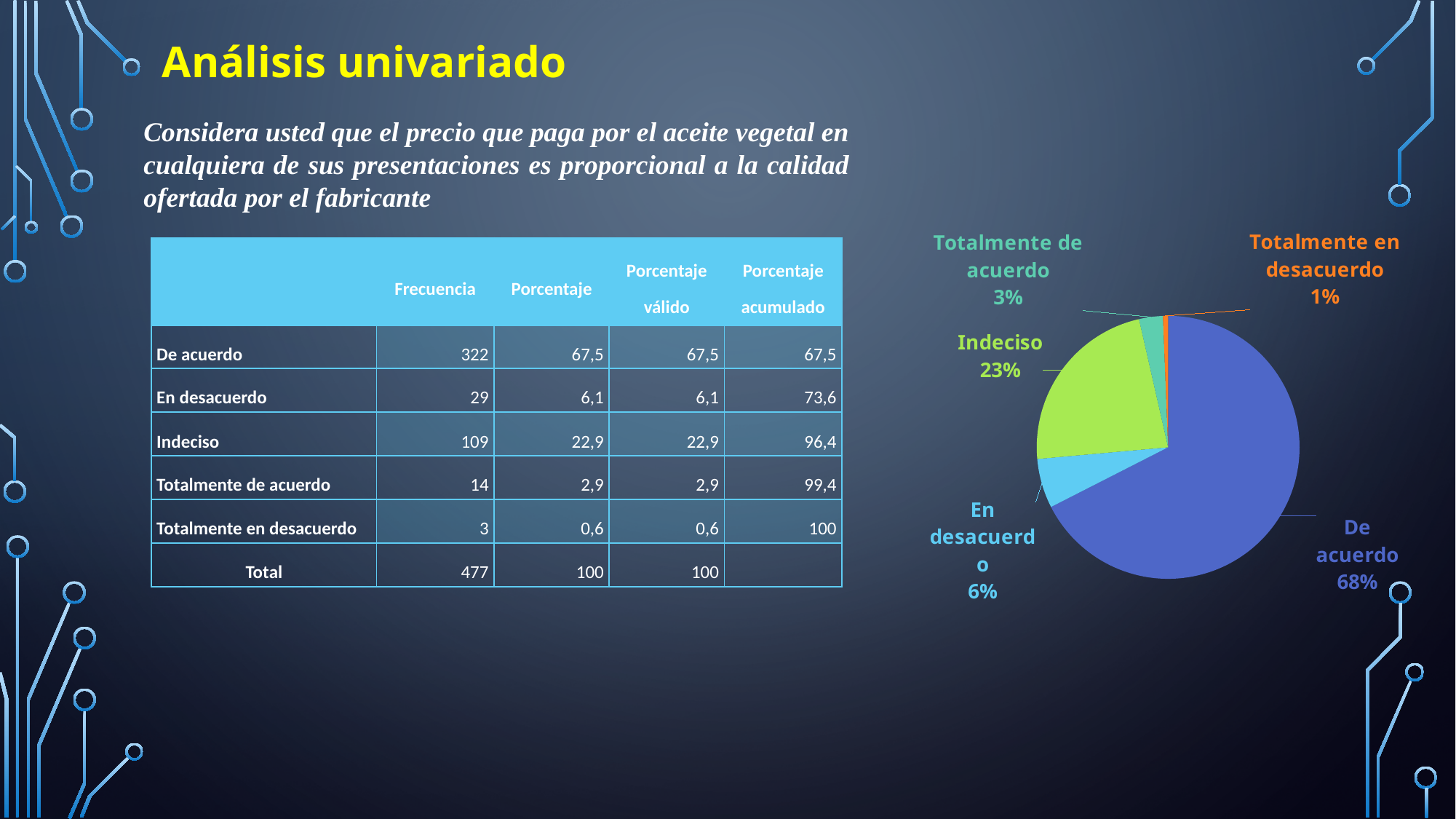
Which slice of the pie chart is the largest? De acuerdo What kind of chart is shown on the slide? pie chart What colour is the De acuerdo slice in the pie chart? blue How many slices does the pie chart have? 5 In the pie chart, what share is labelled for Totalmente de acuerdo? 3% In the pie chart, what share is labelled for Indeciso? 23% In the pie chart, what is the difference in percentage points between De acuerdo and Indeciso? 45 Which slice of the pie chart is the smallest? Totalmente en desacuerdo In the pie chart, what share is labelled for De acuerdo? 68% In the pie chart, what share is labelled for En desacuerdo? 6% In the pie chart, what share is labelled for Totalmente en desacuerdo? 1% In the pie chart, which is larger: Indeciso or En desacuerdo? Indeciso